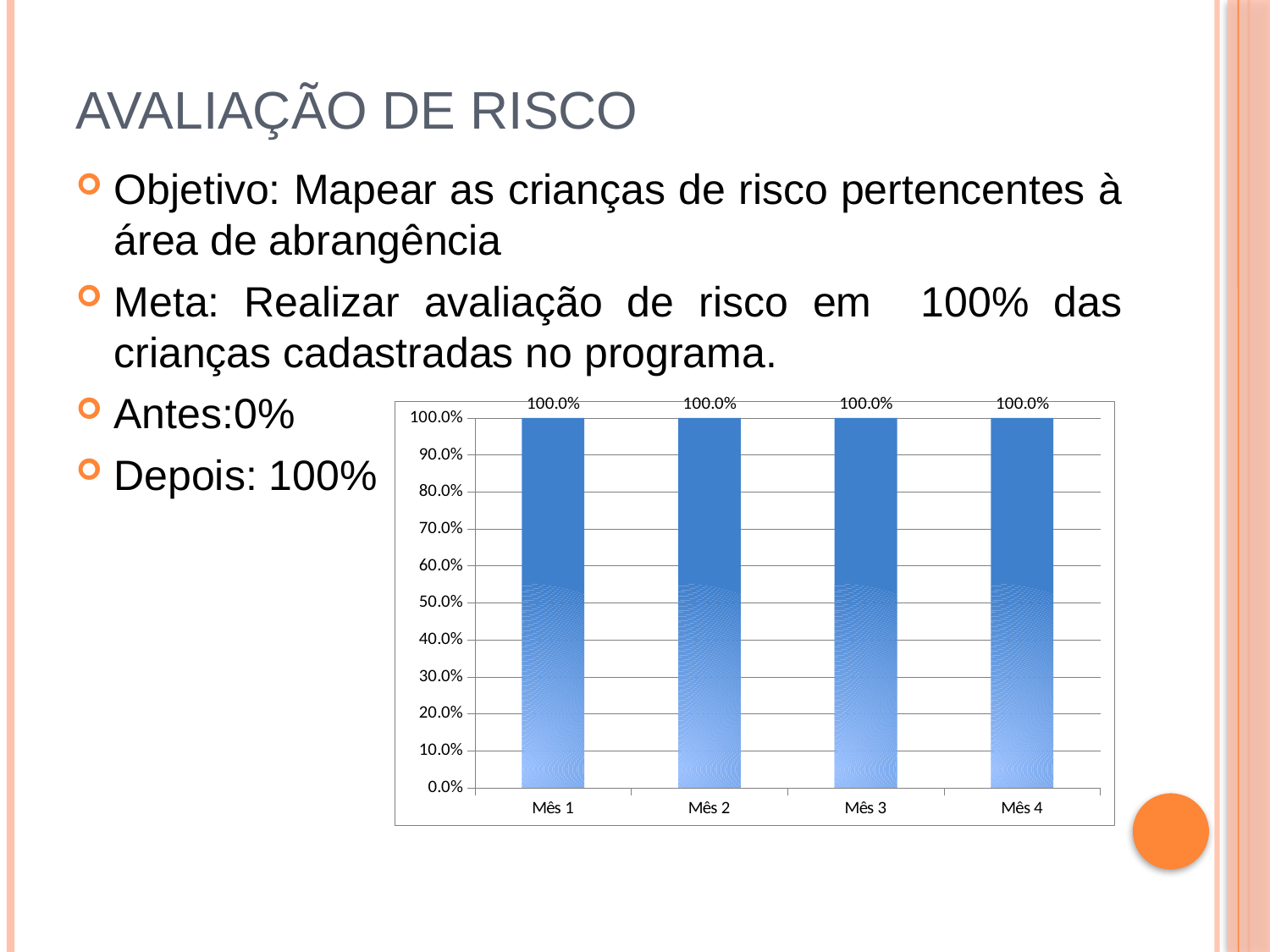
What is the value for Mês 1? 100.0% What is the label of the first category on the x axis? Mês 1 Is the value for Mês 3 greater or less than 50.0%? greater Do the values rise, fall or stay the same from Mês 1 to Mês 4? Stay the same What is the value for Mês 4? 100.0% What is the difference between the values for Mês 1 and Mês 4? 0.0% What is the highest tick value shown on the y axis? 100.0% How many categories are shown on the x axis of the chart? 4 What is the value for Mês 3? 100.0% What is the value for Mês 2? 100.0% Is the value for Mês 2 greater or less than 90.0%? greater What kind of chart is shown on the slide? Bar chart